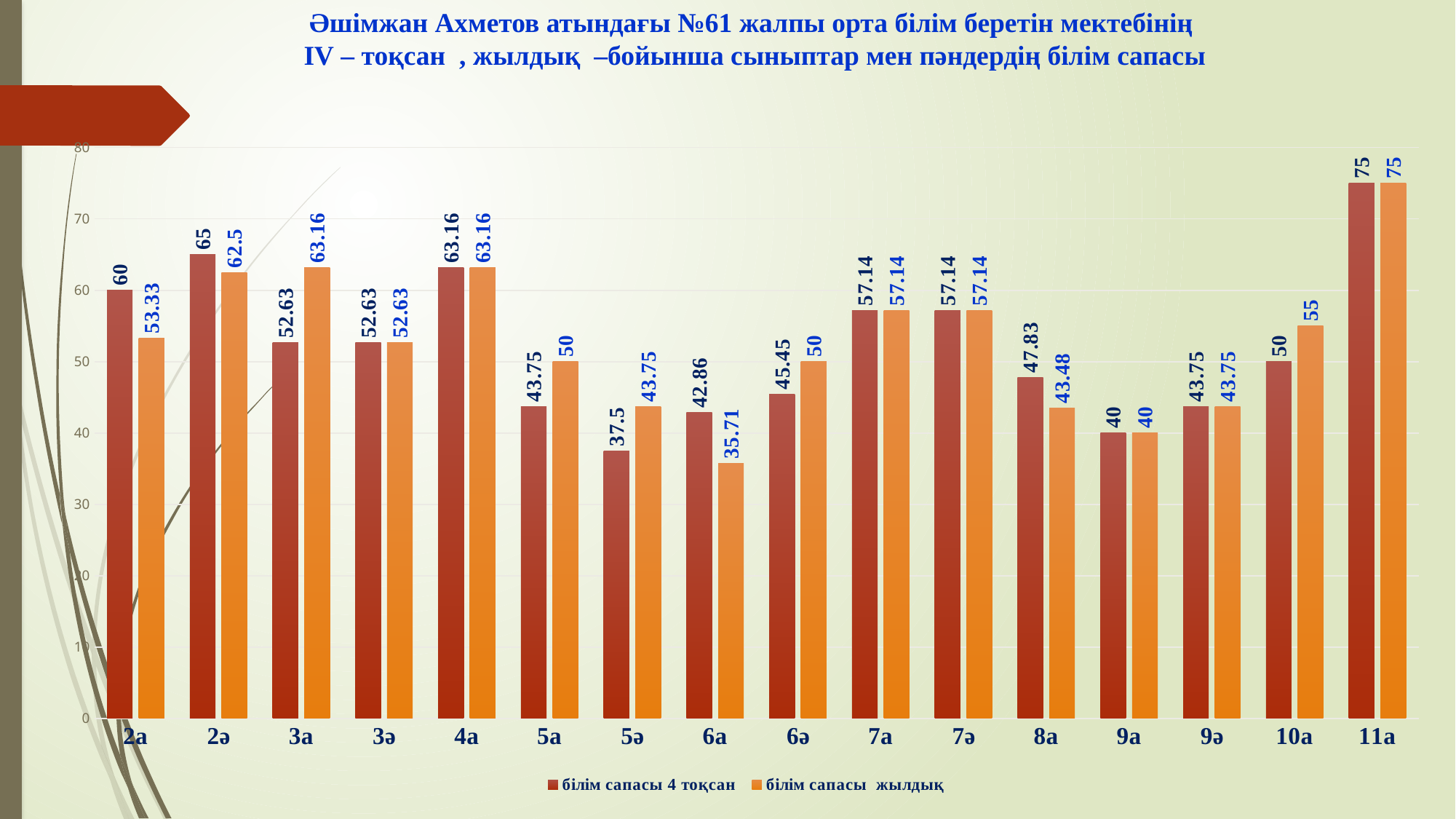
How many classes are shown on the x axis of the chart? 16 How many series does the chart legend list? 2 What is the difference between "білім сапасы жылдық" and "білім сапасы 4 тоқсан" for class 10а? 5 What is the value of "білім сапасы жылдық" for class 3а? 63.16 For class 8а, which is larger: "білім сапасы 4 тоқсан" or "білім сапасы жылдық"? білім сапасы 4 тоқсан What is the value of "білім сапасы 4 тоқсан" for class 2а? 60 Is the value of "білім сапасы 4 тоқсан" for class 2ә greater or less than 60? greater Which class has the lowest value for "білім сапасы 4 тоқсан"? 5ә What is the value of "білім сапасы 4 тоқсан" for class 7ә? 57.14 What kind of chart is shown on the slide? bar chart What is the value of "білім сапасы жылдық" for class 6а? 35.71 Which class has the highest value for "білім сапасы жылдық"? 11а